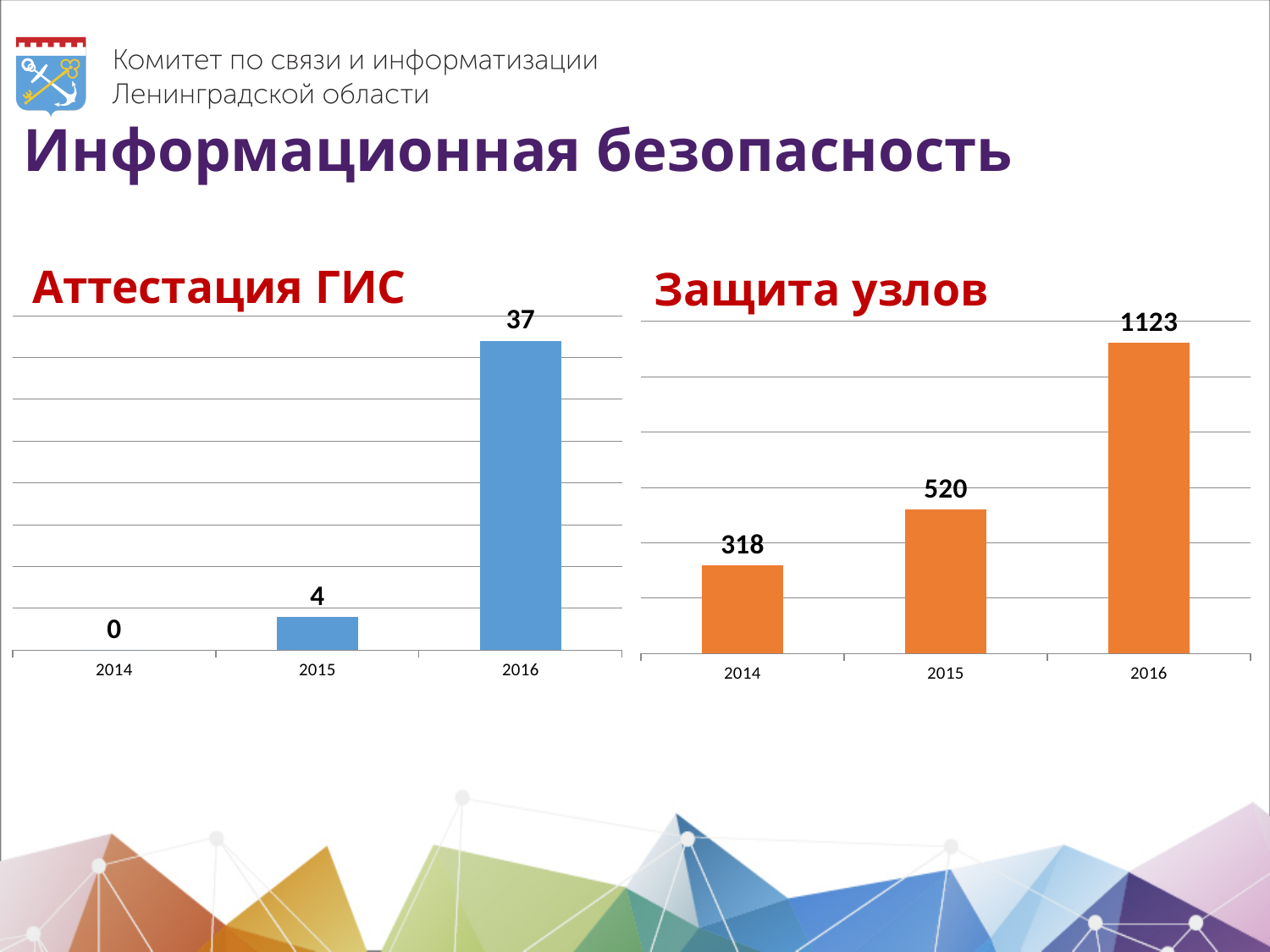
What kind of chart is the 'Аттестация ГИС' chart? bar chart In the 'Защита узлов' chart, what is the value for 2015? 520 In the 'Аттестация ГИС' chart, what is the value for 2014? 0 In the 'Защита узлов' chart, what is the value for 2014? 318 In the 'Аттестация ГИС' chart, which year has the lowest value? 2014 In the 'Защита узлов' chart, which year has the highest value? 2016 In the 'Аттестация ГИС' chart, what is the value for 2016? 37 In the 'Защита узлов' chart, do the values rise or fall from 2014 to 2016? rise In the 'Аттестация ГИС' chart, what is the difference between the values for 2016 and 2015? 33 In the 'Защита узлов' chart, what is the difference between the values for 2016 and 2015? 603 How many years are shown in the 'Защита узлов' chart? 3 In the 'Аттестация ГИС' chart, what is the value for 2015? 4